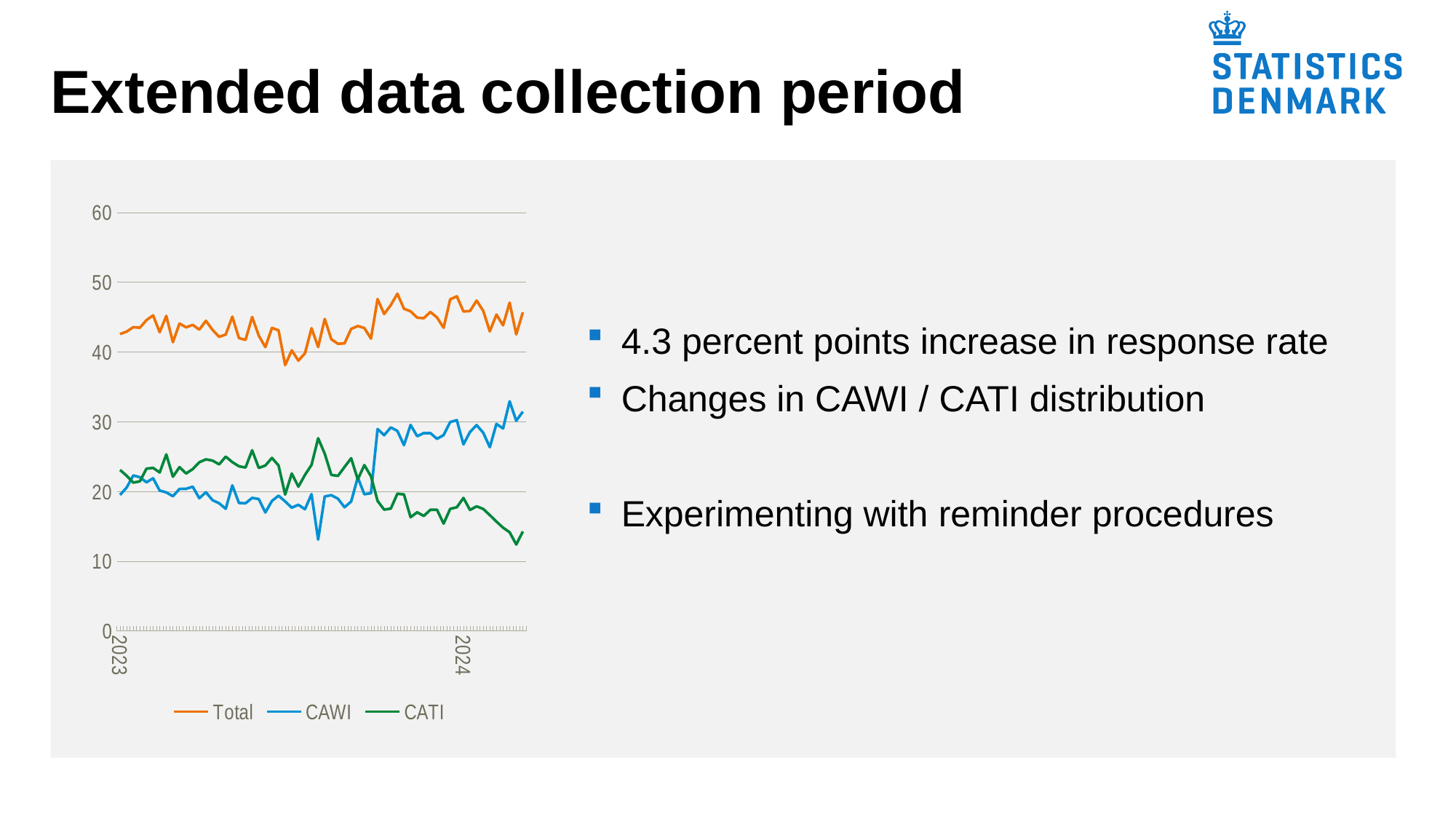
Is the value of the Total series at the start of 2023 greater or less than 40? greater How many series does the chart's legend list? 3 Does the CATI series rise or fall over the 2024 part of the chart? Fall Is the highest value of the Total series greater or less than 50? less What are the series names listed in the chart's legend? Total, CAWI, CATI What kind of chart is shown on the slide? Line chart At the right-hand end of the chart, which is larger, CAWI or CATI? CAWI Does the CAWI series rise or fall from the start of 2023 to the end of the chart? Rise Which series has the highest values across the whole chart? Total Is the lowest value of the CATI series greater or less than 20? less Which series has the lowest values at the right-hand end of the chart? CATI What colour is the Total line in the chart? Orange